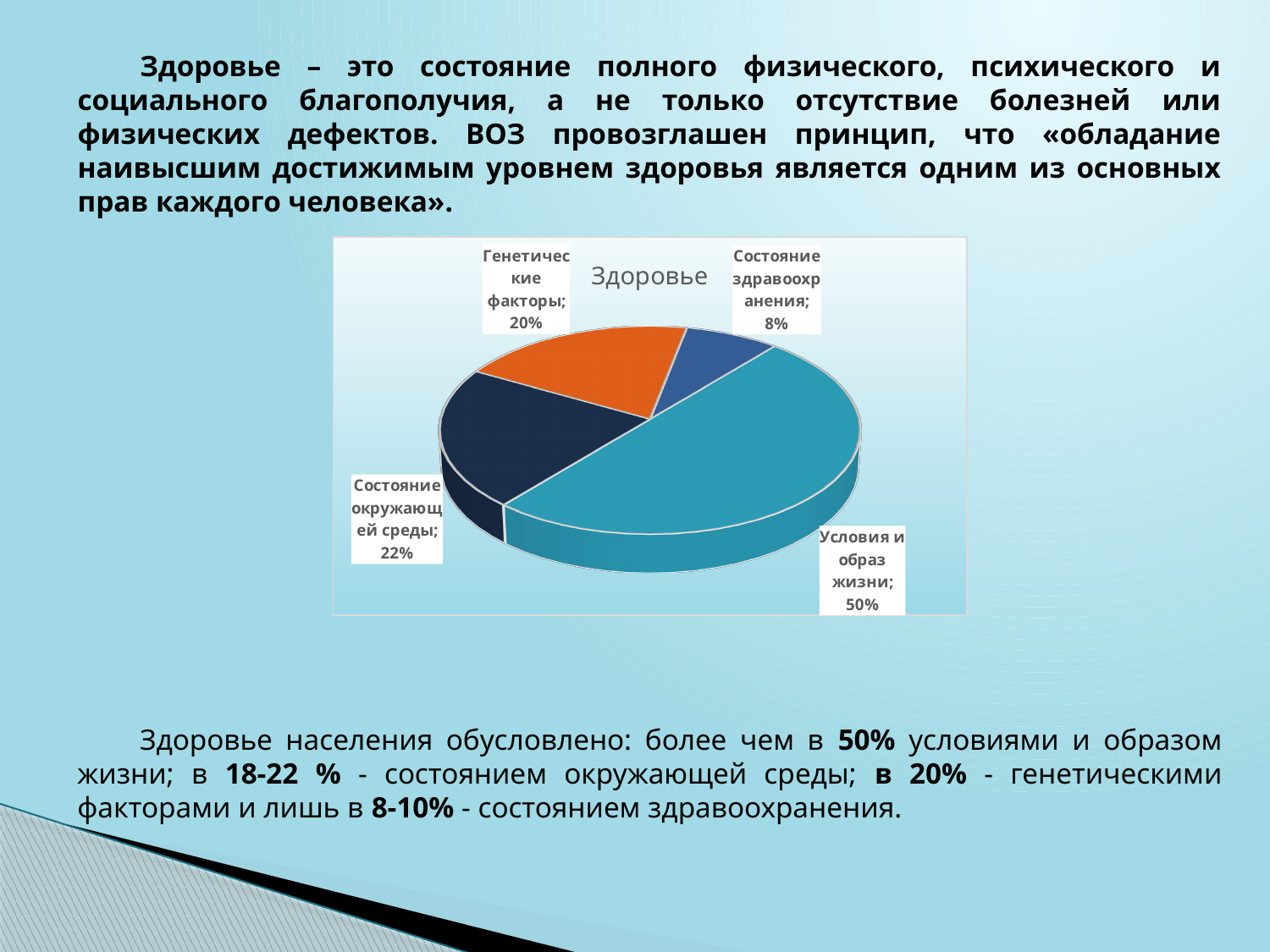
Which slice of the pie chart is the smallest? Состояние здравоохранения What is the difference between the shares for "Условия и образ жизни" and "Состояние окружающей среды"? 28% How many slices does the pie chart have? 4 What colour is the slice for "Генетические факторы"? Orange What share of the pie is labelled "Состояние здравоохранения"? 8% What share of the pie is labelled "Генетические факторы"? 20% What is the title of the chart? Здоровье Which is larger: the share for "Генетические факторы" or the share for "Состояние здравоохранения"? Генетические факторы What share of the pie is labelled "Состояние окружающей среды"? 22% What share of the pie is labelled "Условия и образ жизни"? 50% What kind of chart is shown on the slide? Pie chart Which slice of the pie chart is the largest? Условия и образ жизни